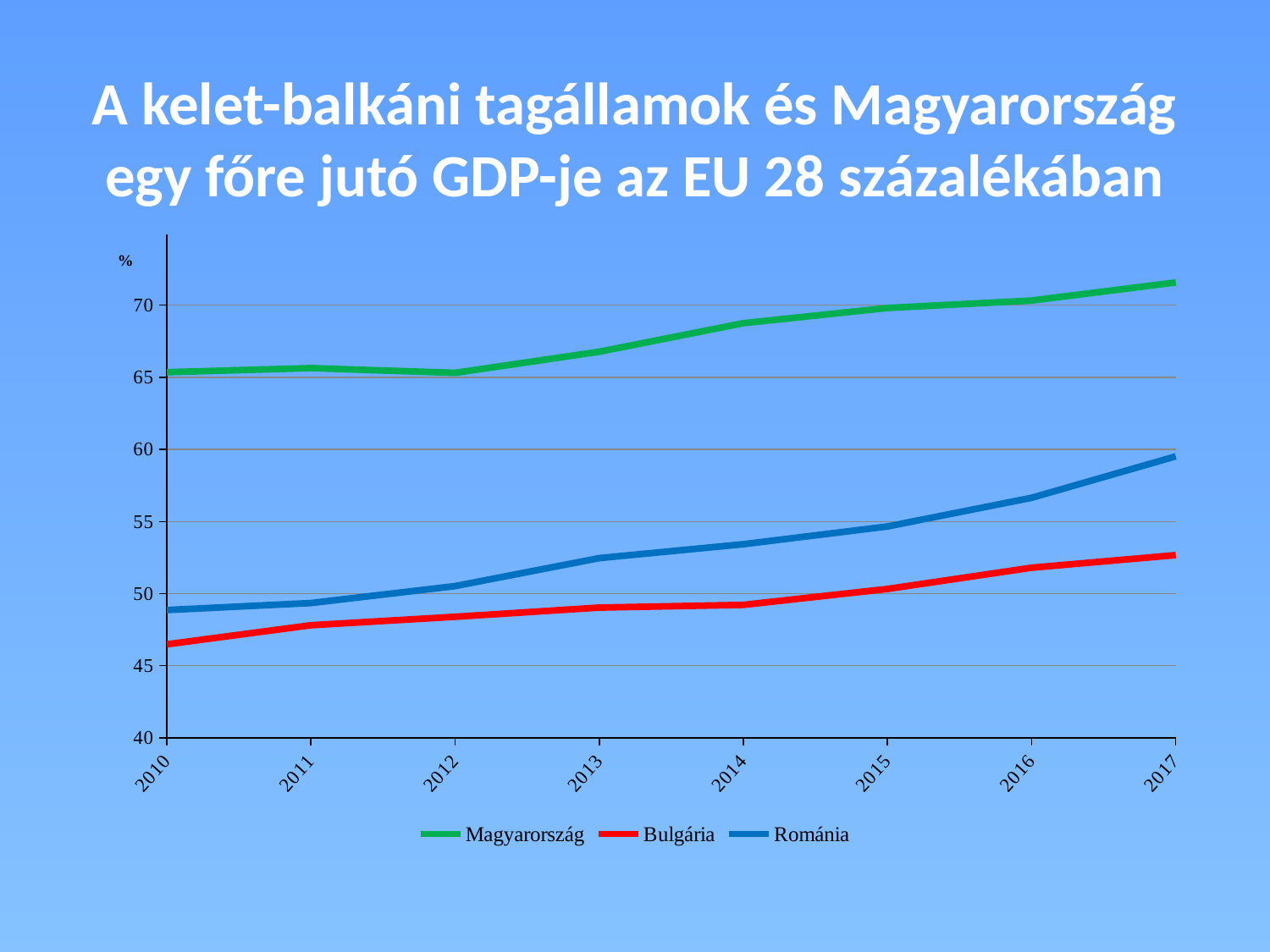
How many years are shown on the x axis? 8 Does the value for Románia rise or fall from 2010 to 2017? rise Is the value for Magyarország in 2014 greater or less than 70? less What kind of chart is shown on the slide? line chart Is the value for Magyarország in 2017 greater or less than 70? greater Which series has the lowest value in 2017? Bulgária Which is larger in 2010, the value for Bulgária or the value for Románia? Románia Is the value for Románia in 2016 greater or less than 55? greater Which series has the highest value in 2017? Magyarország How many series does the legend list? 3